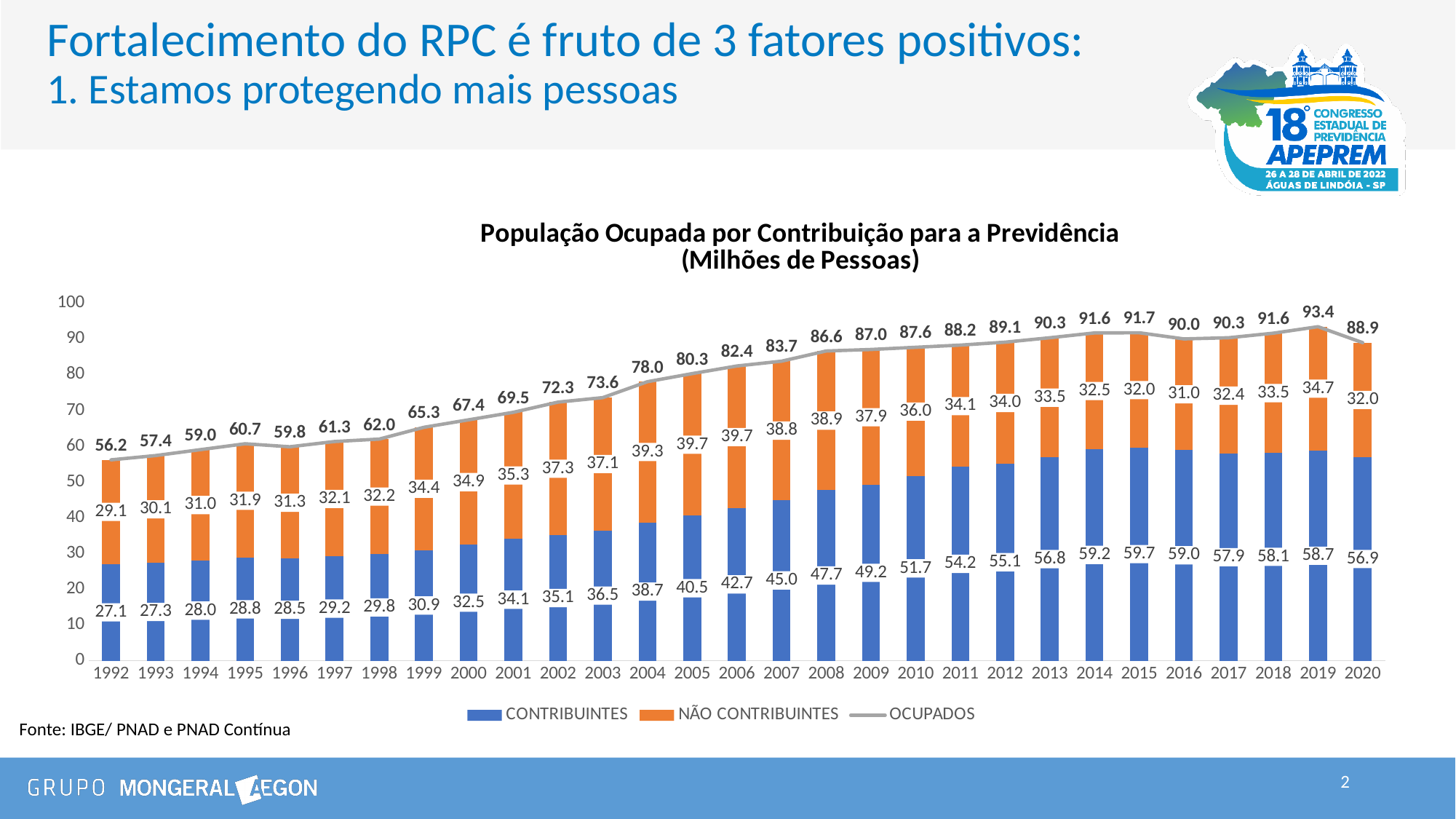
What is the value for CONTRIBUINTES in 2020? 56.9 How many series does the legend list? 3 In which year is the OCUPADOS line at its highest? 2019 What is the value for NÃO CONTRIBUINTES in 2008? 38.9 Is the OCUPADOS value for 2004 greater or less than 70? greater What is the total of the stacked bar for 2020 (CONTRIBUINTES plus NÃO CONTRIBUINTES)? 88.9 What is the difference between the OCUPADOS value in 2020 and in 1992? 32.7 In which year is the CONTRIBUINTES value the lowest? 1992 What is the OCUPADOS value for 2019? 93.4 How many years are shown on the x axis? 29 Which year has the larger NÃO CONTRIBUINTES value, 2006 or 2020? 2006 What kind of chart is this? Stacked bar chart with a line